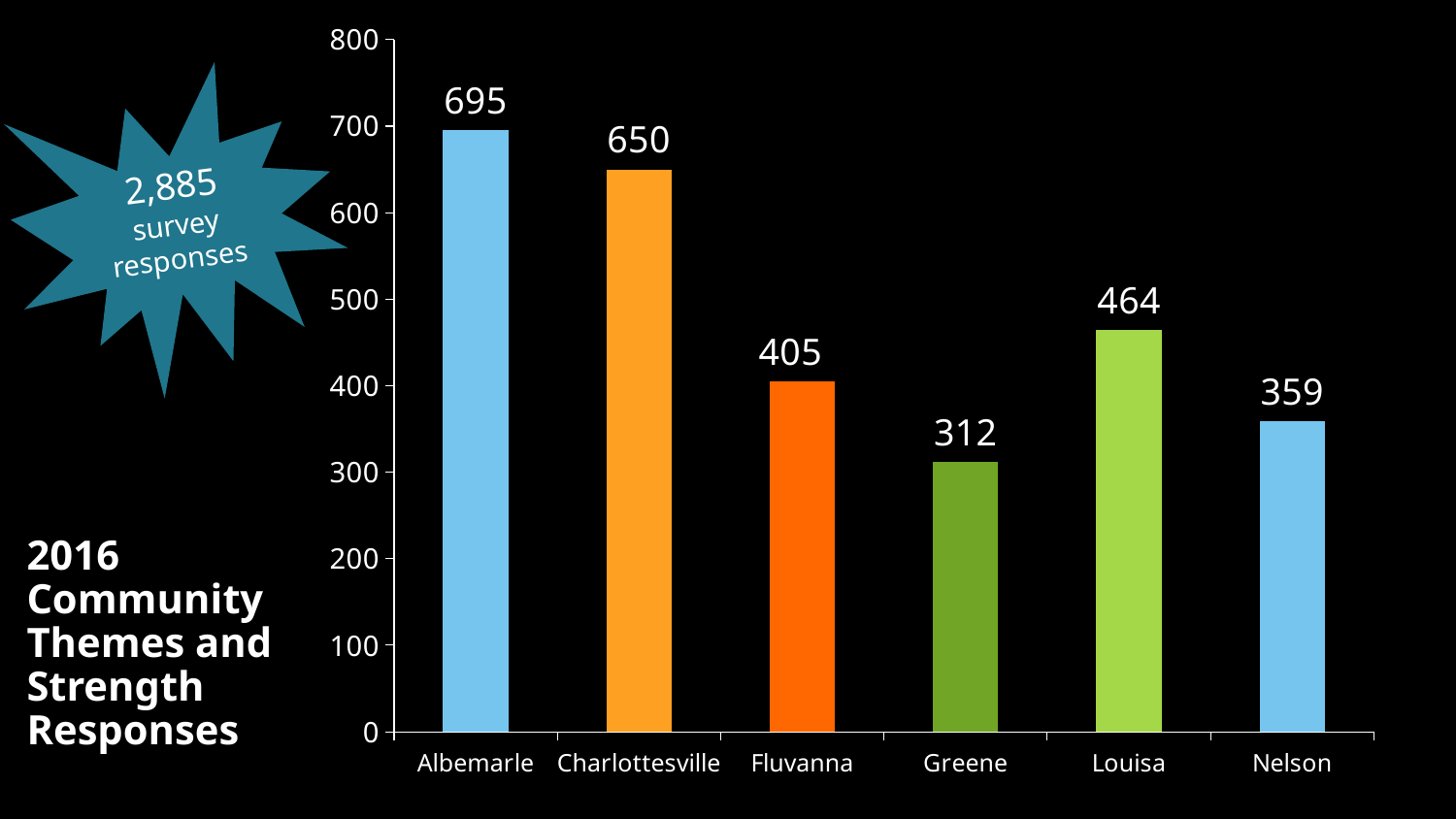
Which category has the lowest value? Greene What is the difference between the values for Albemarle and Charlottesville? 45 What kind of chart is shown on the slide? bar chart What is the total number of survey responses stated in the starburst on the slide? 2,885 What is the value for Greene? 312 Which is larger, the value for Fluvanna or the value for Louisa? Louisa What is the value for Albemarle? 695 Is the value for Nelson greater or less than 400? less What is the difference between the values for Louisa and Nelson? 105 How many categories are shown on the x axis? 6 Which category has the highest value? Albemarle What is the value for Louisa? 464